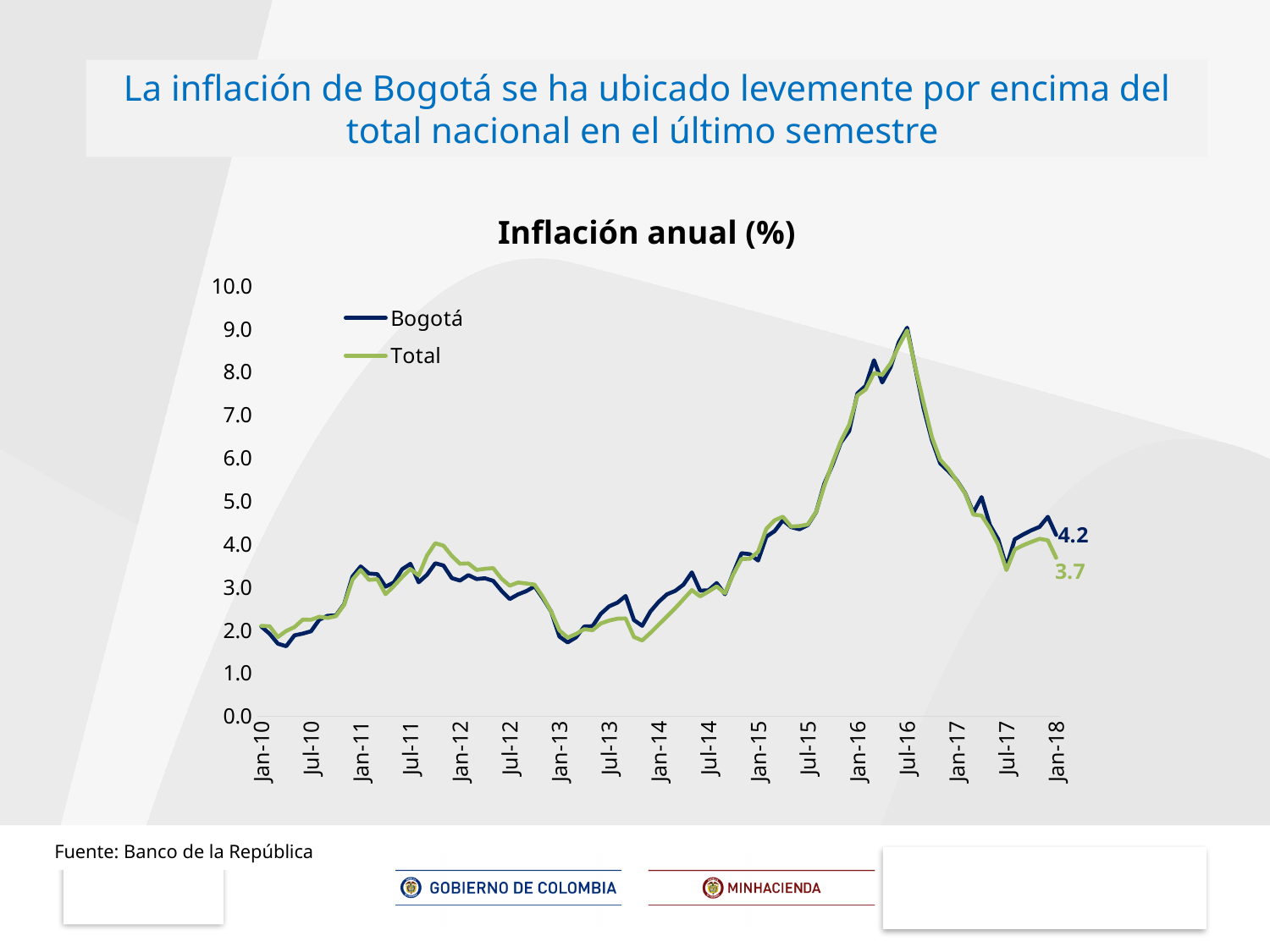
Which series are listed in the chart legend? Bogotá and Total At which date on the x axis does the Total series reach its highest value? Jul-16 What is the value of the Bogotá series at Jan-18? 4.2 Is the value of the Total series at Jul-16 greater or less than 8.0? greater What is the difference between the Bogotá and Total values at Jan-18? 0.5 How many series does the legend list? 2 What is the title of the chart? Inflación anual (%) What is the value of the Total series at Jan-18? 3.7 What kind of chart is shown on the slide? Line chart Is the value of the Bogotá series at Jan-13 greater or less than 3.0? less At Jan-18, which series has the higher value, Bogotá or Total? Bogotá Do the values of the Total series rise or fall between Jul-16 and Jul-17? fall